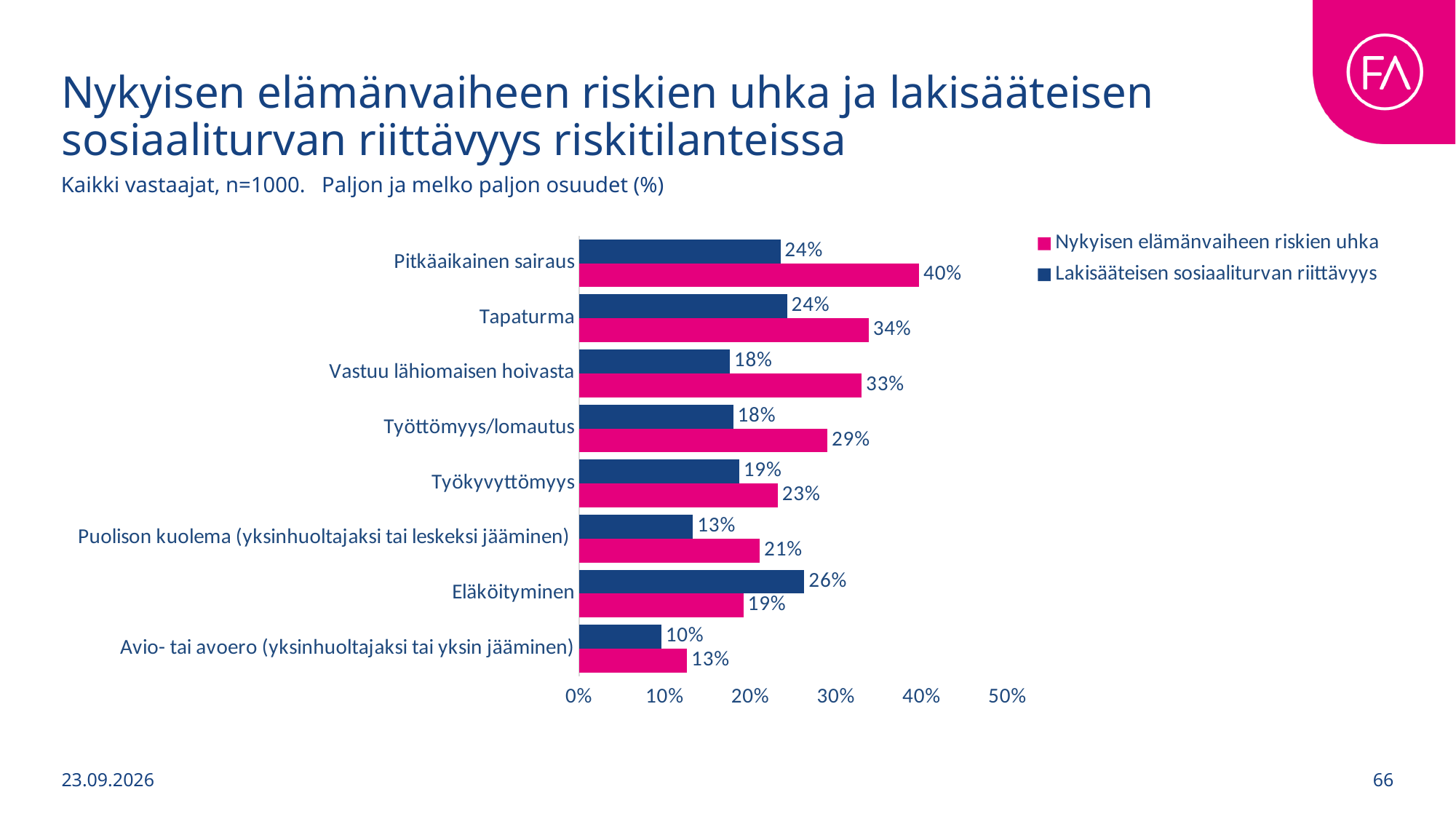
How many series does the legend list? 2 Is the value of 'Nykyisen elämänvaiheen riskien uhka' for Tapaturma greater or less than 30%? greater What is the value of 'Lakisääteisen sosiaaliturvan riittävyys' for Eläköityminen? 26% Which colour represents 'Nykyisen elämänvaiheen riskien uhka' in the legend? Pink (magenta) What kind of chart is shown on the slide? Bar chart What is the value of 'Nykyisen elämänvaiheen riskien uhka' for Pitkäaikainen sairaus? 40% For Eläköityminen, which series has the larger value? Lakisääteisen sosiaaliturvan riittävyys What is the value of 'Nykyisen elämänvaiheen riskien uhka' for Työttömyys/lomautus? 29% What is the difference between the two series for Vastuu lähiomaisen hoivasta? 15 percentage points How many categories are shown on the chart? 8 Which category has the lowest value for 'Lakisääteisen sosiaaliturvan riittävyys'? Avio- tai avoero (yksinhuoltajaksi tai yksin jääminen) Which category has the highest value for 'Nykyisen elämänvaiheen riskien uhka'? Pitkäaikainen sairaus